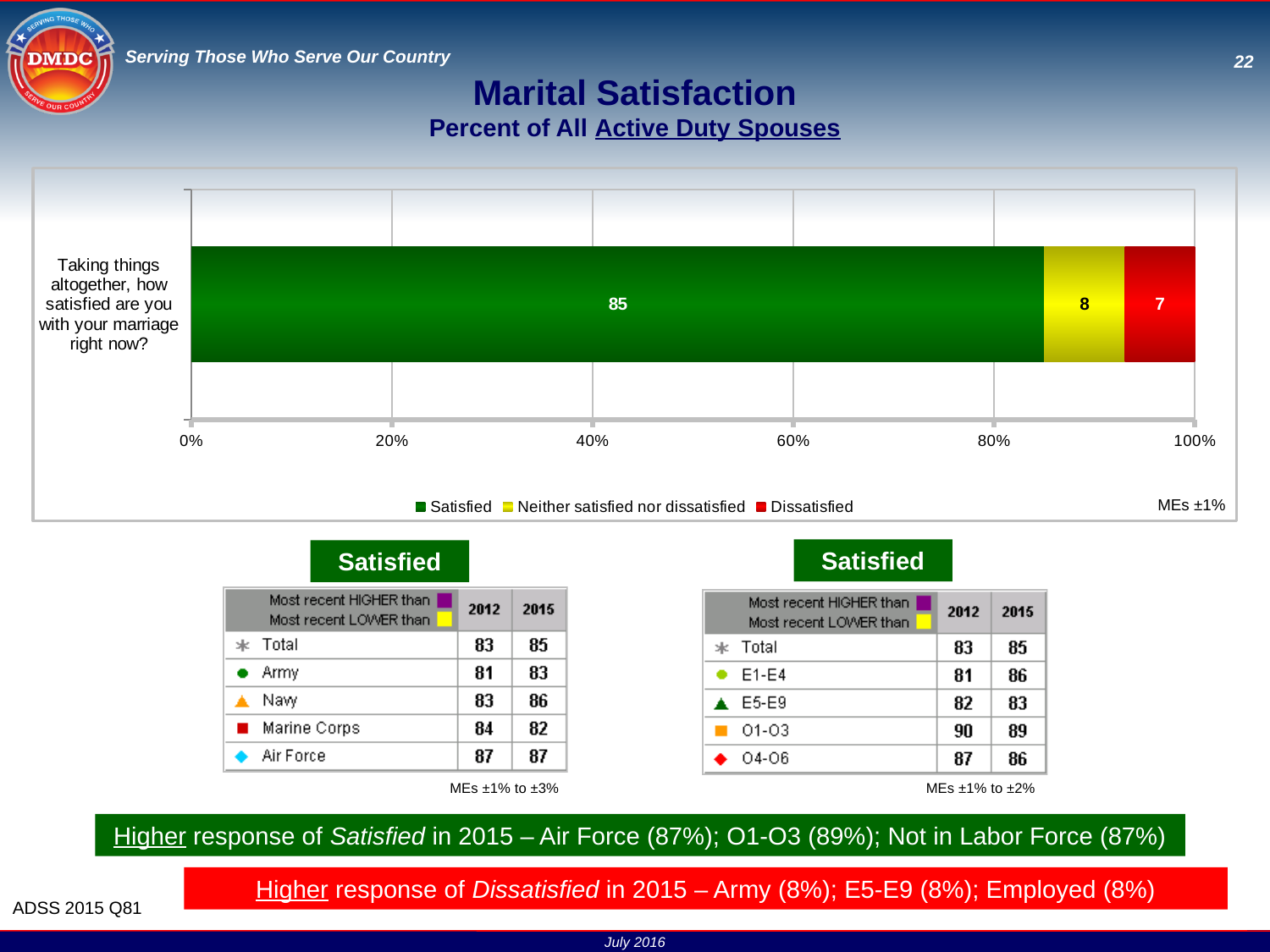
Is the Satisfied value greater or less than 80%? greater What percentage of active duty spouses are Satisfied with their marriage? 85 Which is larger, the Satisfied segment or the Neither satisfied nor dissatisfied segment? Satisfied What value is shown for Neither satisfied nor dissatisfied? 8 Which response category has the lowest value in the bar? Dissatisfied What is the total of the three segments in the stacked bar? 100 How many series does the chart legend list? 3 Which response category has the highest value in the bar? Satisfied What is the difference between the Neither satisfied nor dissatisfied value and the Dissatisfied value? 1 What is the difference between the Satisfied value and the Dissatisfied value? 78 What value is shown for Dissatisfied? 7 What type of chart is shown on the slide? Stacked bar chart